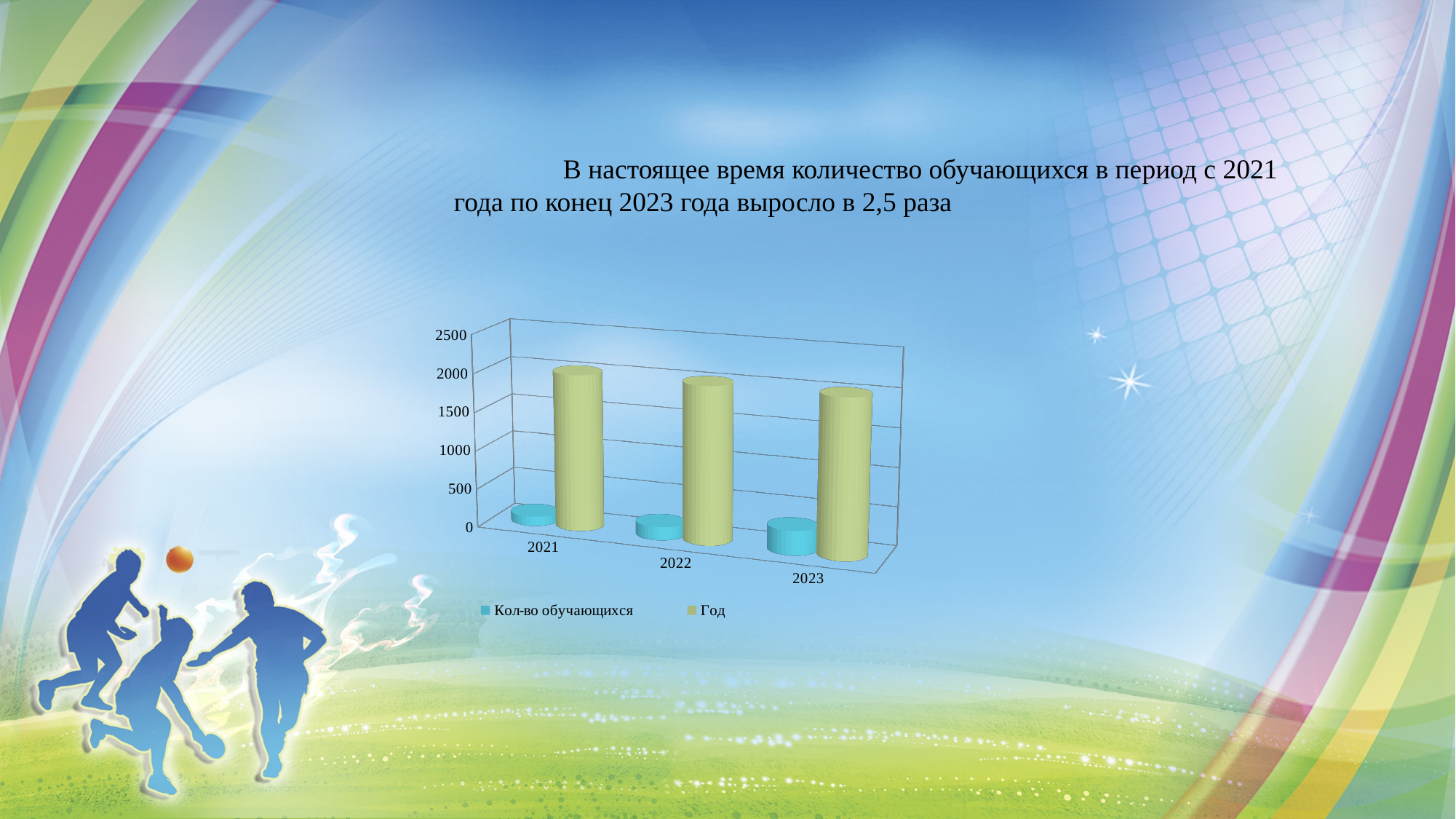
How many years are shown on the x axis of the chart? 3 Which year has the lowest value for "Кол-во обучающихся"? 2021 Is the value for "Год" in 2021 greater or less than 1000? greater Which colour represents the series "Кол-во обучающихся" in the chart? Blue What are the two series named in the chart legend? Кол-во обучающихся and Год Do the values for "Кол-во обучающихся" rise or fall from 2021 to 2023? Rise How many series does the chart legend list? 2 Is the value for "Кол-во обучающихся" in 2023 greater or less than 500? less What kind of chart is shown on the slide? Bar chart Is the value for "Кол-во обучающихся" in 2021 greater or less than 500? less Which year has the highest value for "Кол-во обучающихся"? 2023